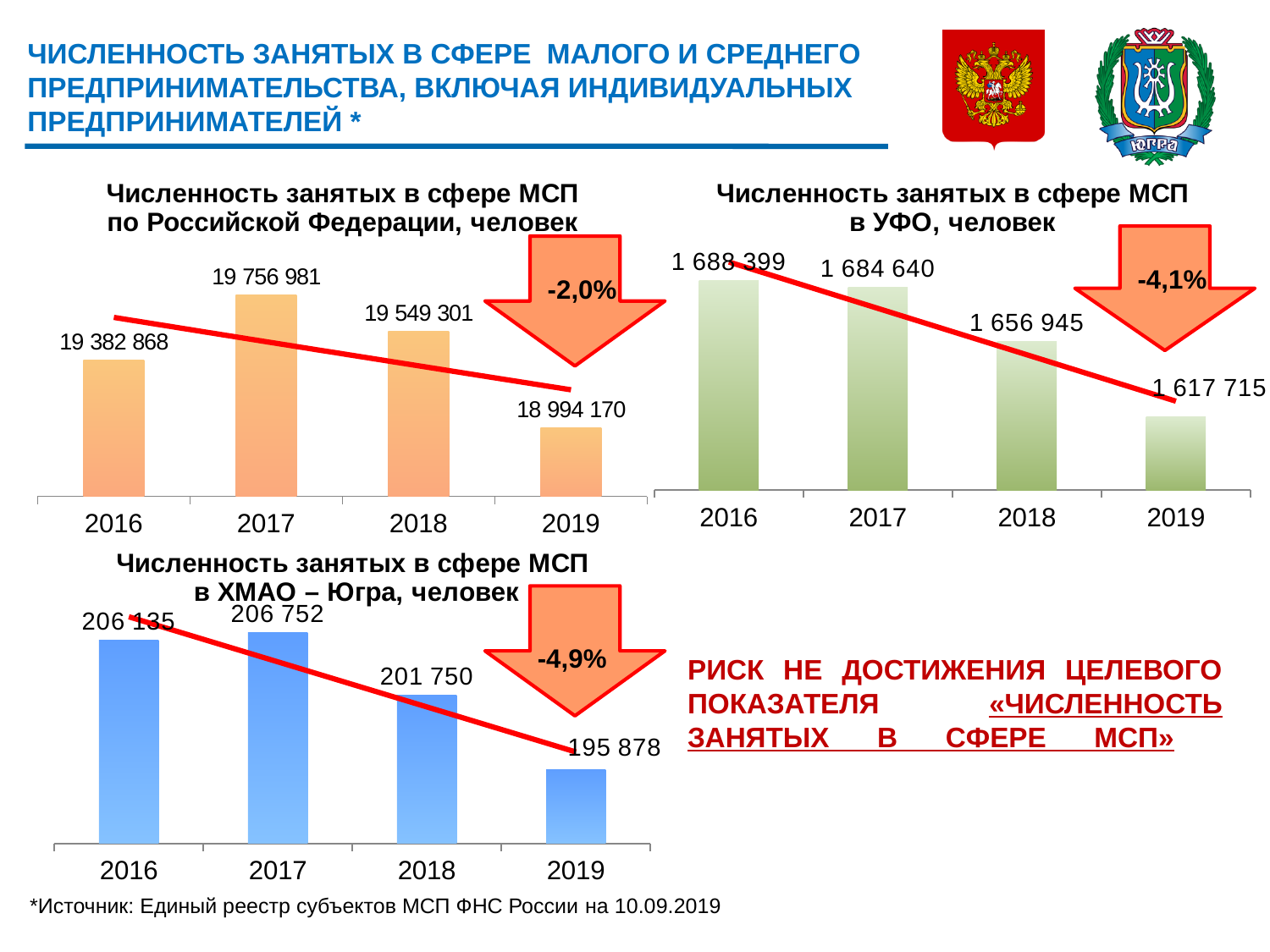
In the chart 'Численность занятых в сфере МСП в УФО, человек', what is the difference between the 2016 and 2019 values? 70 684 What kind of chart is 'Численность занятых в сфере МСП по Российской Федерации, человек'? bar chart What percentage change is shown in the arrow next to the chart 'Численность занятых в сфере МСП в ХМАО – Югра, человек'? -4,9% In the chart 'Численность занятых в сфере МСП по Российской Федерации, человек', what is the value for 2017? 19 756 981 How many years are shown in the chart 'Численность занятых в сфере МСП в УФО, человек'? 4 In the chart 'Численность занятых в сфере МСП в УФО, человек', what is the value for 2019? 1 617 715 In the chart 'Численность занятых в сфере МСП в ХМАО – Югра, человек', what is the difference between the 2017 and 2018 values? 5 002 In the chart 'Численность занятых в сфере МСП в ХМАО – Югра, человек', what is the value for 2018? 201 750 In the chart 'Численность занятых в сфере МСП в ХМАО – Югра, человек', which is larger, the value for 2017 or the value for 2019? 2017 In the chart 'Численность занятых в сфере МСП в УФО, человек', do the values rise or fall from 2016 to 2019? fall In the chart 'Численность занятых в сфере МСП по Российской Федерации, человек', which year has the lowest value? 2019 In the chart 'Численность занятых в сфере МСП по Российской Федерации, человек', which year has the highest value? 2017